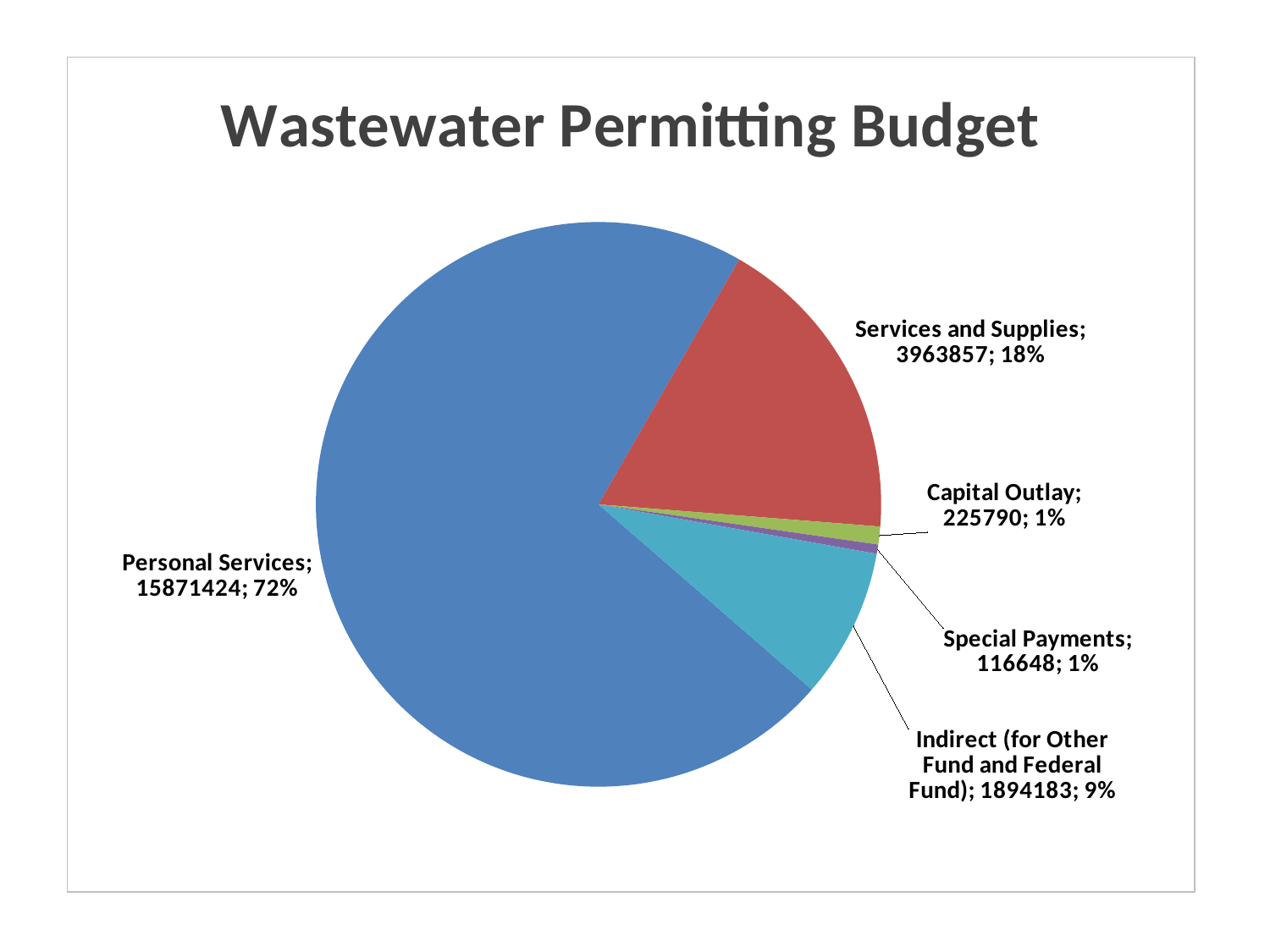
Which category has the smallest slice? Special Payments What share of the pie does Services and Supplies represent? 18% What kind of chart is shown on the slide? Pie chart What share of the pie does Indirect (for Other Fund and Federal Fund) represent? 9% What is the value for Capital Outlay? 225790 What is the difference between the values for Services and Supplies and Indirect (for Other Fund and Federal Fund)? 2069674 What is the value for Special Payments? 116648 Which category has the largest slice? Personal Services What is the value for Personal Services? 15871424 What is the value for Indirect (for Other Fund and Federal Fund)? 1894183 What is the value for Services and Supplies? 3963857 How many categories are shown in the pie chart? 5